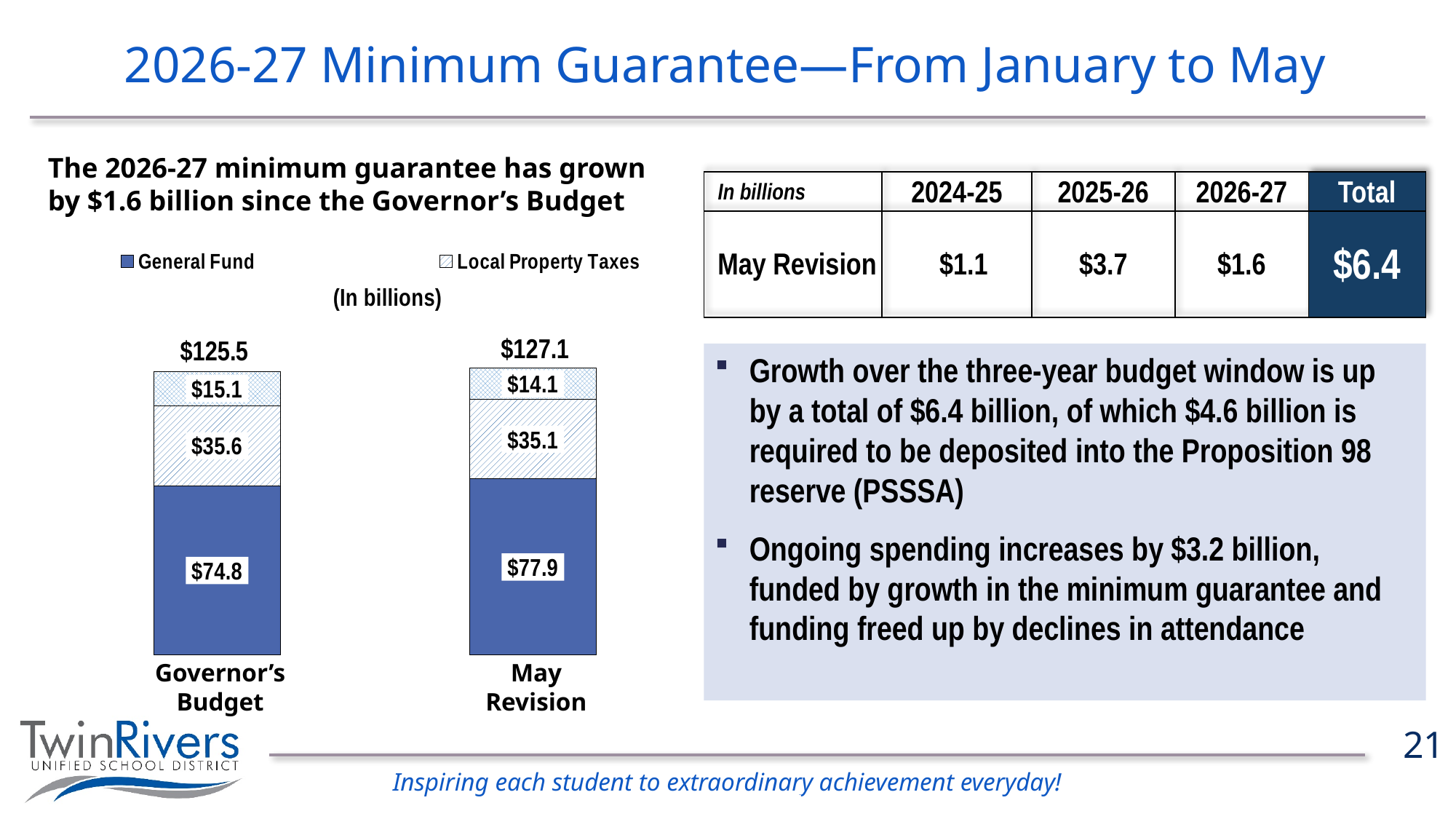
Which bar has the larger total, Governor's Budget or May Revision? May Revision What is the difference between the General Fund values for May Revision and Governor's Budget? $3.1 What type of chart is shown on the slide? stacked bar chart What is the General Fund value for the Governor's Budget bar? $74.8 How many bars (categories) does the chart show? 2 What unit does the chart say its values are in? In billions What is the value of the top segment of the May Revision bar? $14.1 What is the Local Property Taxes value for the Governor's Budget bar? $35.6 What is the total value shown above the May Revision bar? $127.1 What is the total value shown above the Governor's Budget bar? $125.5 What is the General Fund value for the May Revision bar? $77.9 What is the Local Property Taxes value for the May Revision bar? $35.1